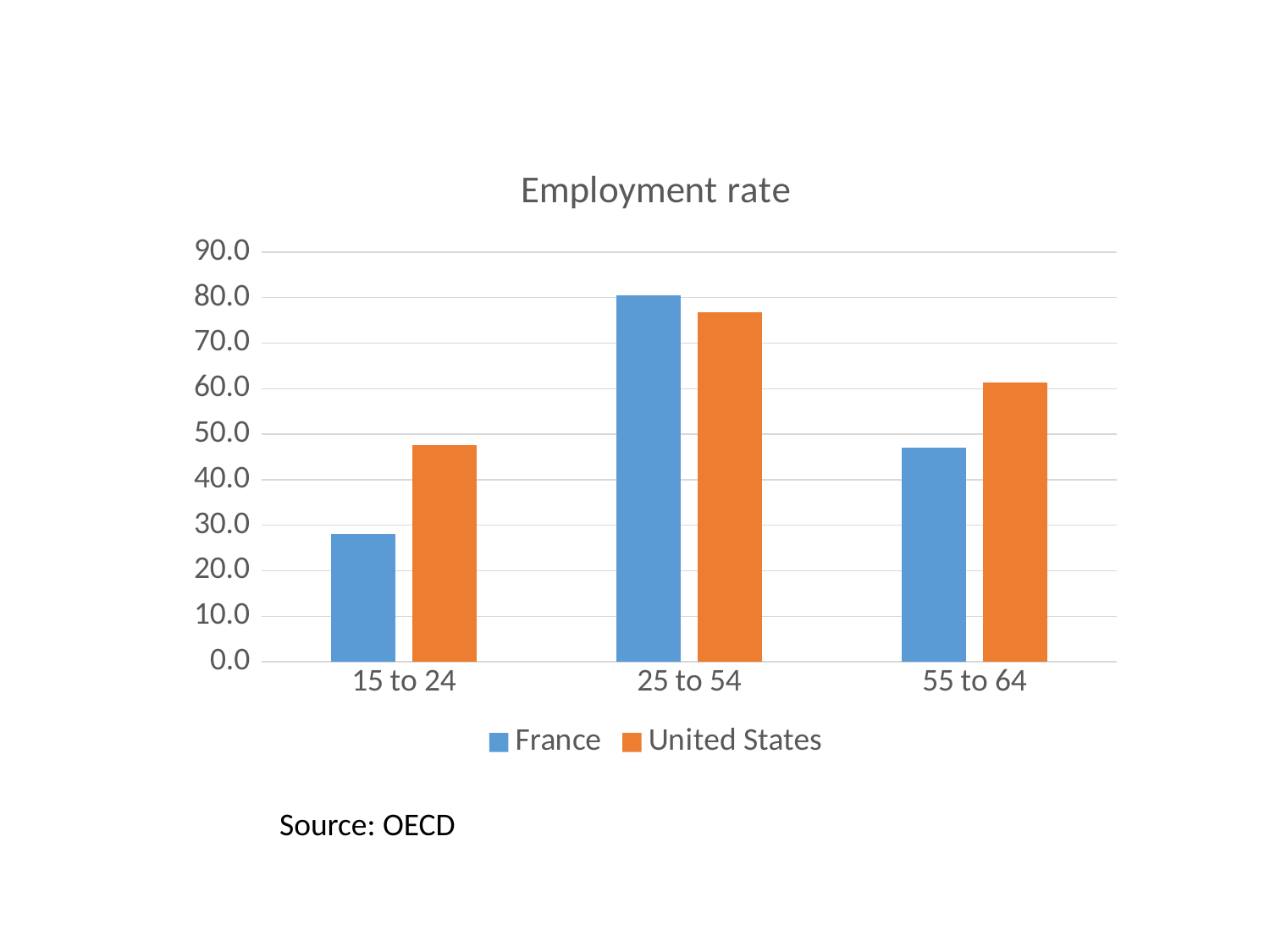
What is the title of the chart? Employment rate How many series does the legend list? 2 Which age group has the lowest employment rate for the United States? 15 to 24 What kind of chart is shown on the slide? bar chart Which series is shown in orange in the legend? United States How many age-group categories are shown on the x axis? 3 For the 15 to 24 age group, which has the larger employment rate, France or the United States? United States Which age group has the lowest employment rate for France? 15 to 24 Is the employment rate for France in the 15 to 24 age group greater or less than 30.0? less Is the employment rate for the United States in the 55 to 64 age group greater or less than 60.0? greater Which age group has the highest employment rate for France? 25 to 54 For the 25 to 54 age group, which has the larger employment rate, France or the United States? France